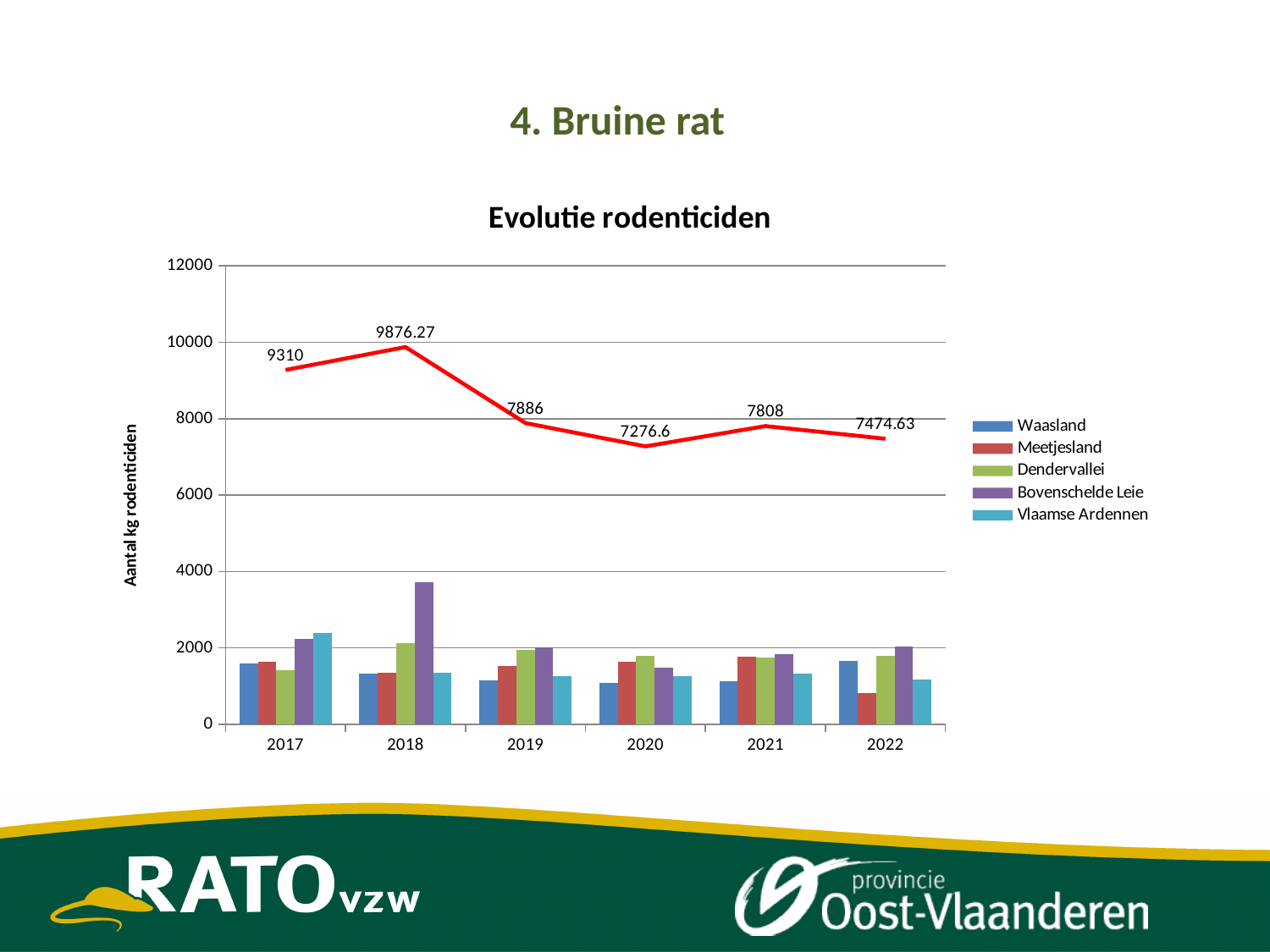
In which year does the red line reach its lowest labelled value? 2020 What is the difference between the red line values for 2018 and 2019? 1990.27 Is the value for Bovenschelde Leie in 2018 greater or less than 2000? greater Which region has the tallest bar in 2018? Bovenschelde Leie How many years are shown on the x axis? 6 What value is labelled on the red line for 2020? 7276.6 Does the red line rise or fall from 2018 to 2020? fall How many series does the legend list? 5 What value is labelled on the red line for 2022? 7474.63 Which year has the larger red line value, 2021 or 2022? 2021 In which year does the red line reach its highest labelled value? 2018 What value is labelled on the red line for 2018? 9876.27